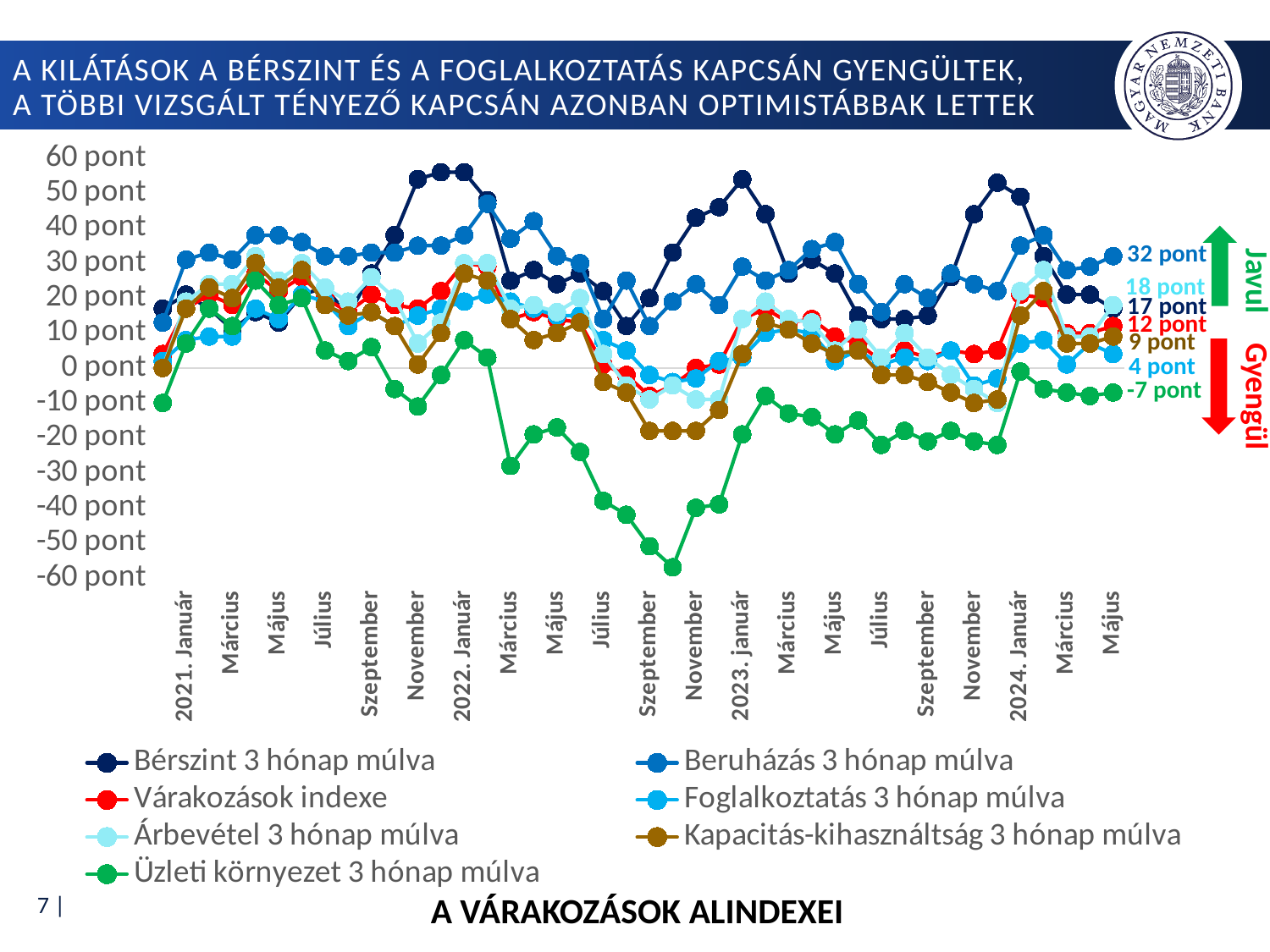
What is the difference between the latest values of Beruházás 3 hónap múlva (32 pont) and Bérszint 3 hónap múlva (17 pont)? 15 pont Which series has the highest value at the end of the chart (May 2024)? Beruházás 3 hónap múlva What is the latest value shown for the Beruházás 3 hónap múlva series? 32 pont At the end of the chart, which is larger: the value for Árbevétel 3 hónap múlva or for Kapacitás-kihasználtság 3 hónap múlva? Árbevétel 3 hónap múlva What is the latest value shown for the Foglalkoztatás 3 hónap múlva series? 4 pont What is the latest value shown for the Várakozások indexe series? 12 pont Is the value for Üzleti környezet 3 hónap múlva in September 2022 greater or less than -40 pont? less What kind of chart is shown on the slide? Line chart Which series has the lowest value at the end of the chart (May 2024)? Üzleti környezet 3 hónap múlva How many series does the legend list? 7 What is the title of the chart at the bottom of the slide? A VÁRAKOZÁSOK ALINDEXEI What is the latest value shown for the Üzleti környezet 3 hónap múlva series? -7 pont